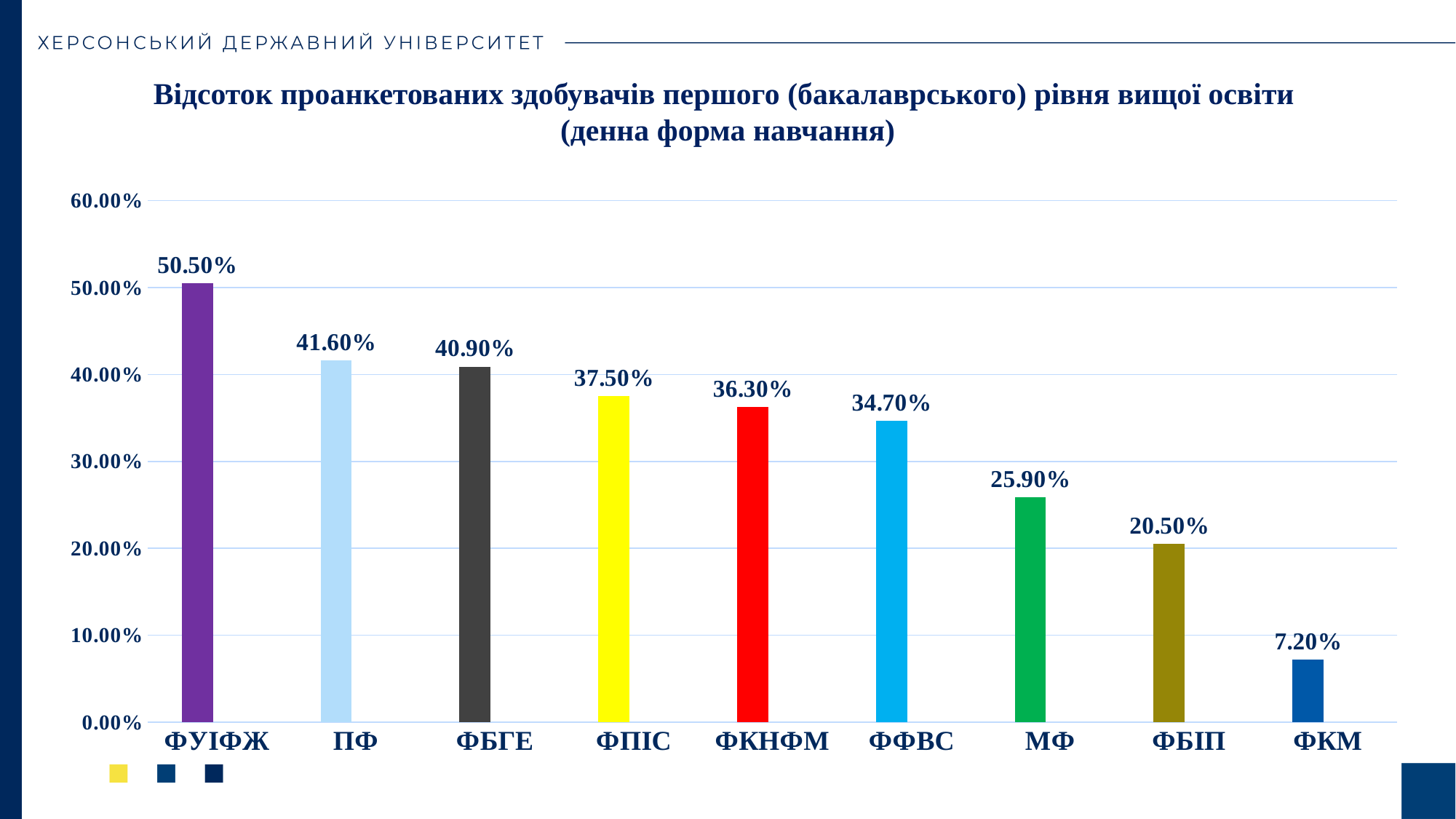
Do the values rise or fall from left to right along the x axis? fall Which category has the highest value? ФУІФЖ What is the difference between the values for ФУІФЖ and ФКМ? 43.30% What is the difference between the values for МФ and ФБІП? 5.40% What kind of chart is shown on the slide? bar chart What is the value for ФУІФЖ? 50.50% Is the value for МФ greater or less than 30.00%? less How many categories are shown on the x axis? 9 Which is larger, the value for ФПІС or the value for ФФВС? ФПІС What is the value for ФБІП? 20.50% What is the value for ФКНФМ? 36.30% Which category has the lowest value? ФКМ